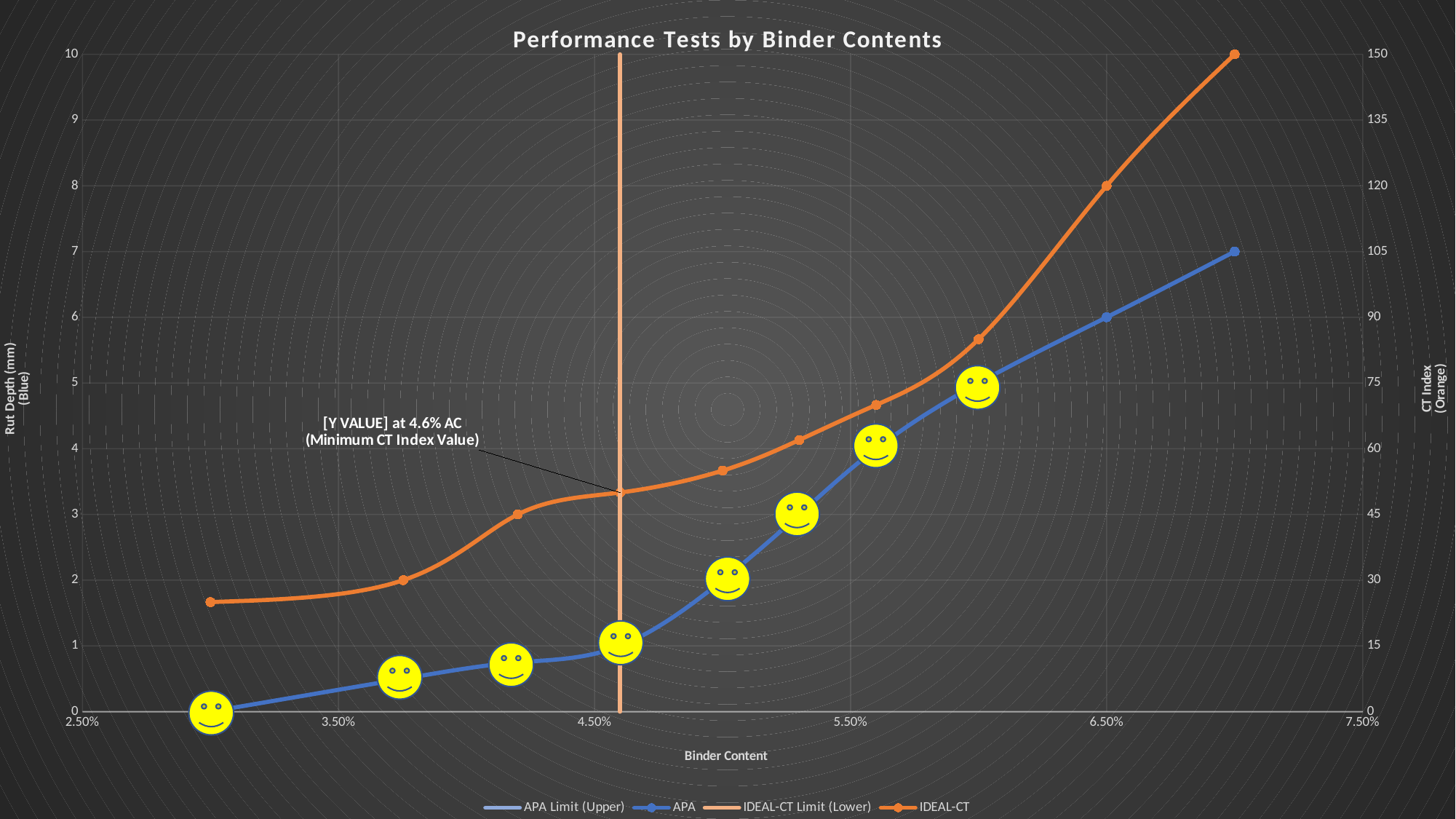
What is the label of the x axis? Binder Content What kind of chart is shown on the slide? line chart Does the IDEAL-CT series rise or fall as binder content increases? rises Does the APA series rise or fall as binder content increases? rises What is the APA rut depth value at a binder content of 6.50%? 6 Is the APA rut depth at a binder content of 5.50% greater or less than 5? less How many entries does the chart legend list? 4 What is the title of the chart? Performance Tests by Binder Contents What is the IDEAL-CT index value at a binder content of 6.50%? 120 At what binder content is the vertical IDEAL-CT Limit (Lower) line drawn, according to the annotation? 4.6% AC How many data points are plotted for the APA series? 10 Is the IDEAL-CT value at a binder content of 5.50% greater or less than 60? greater